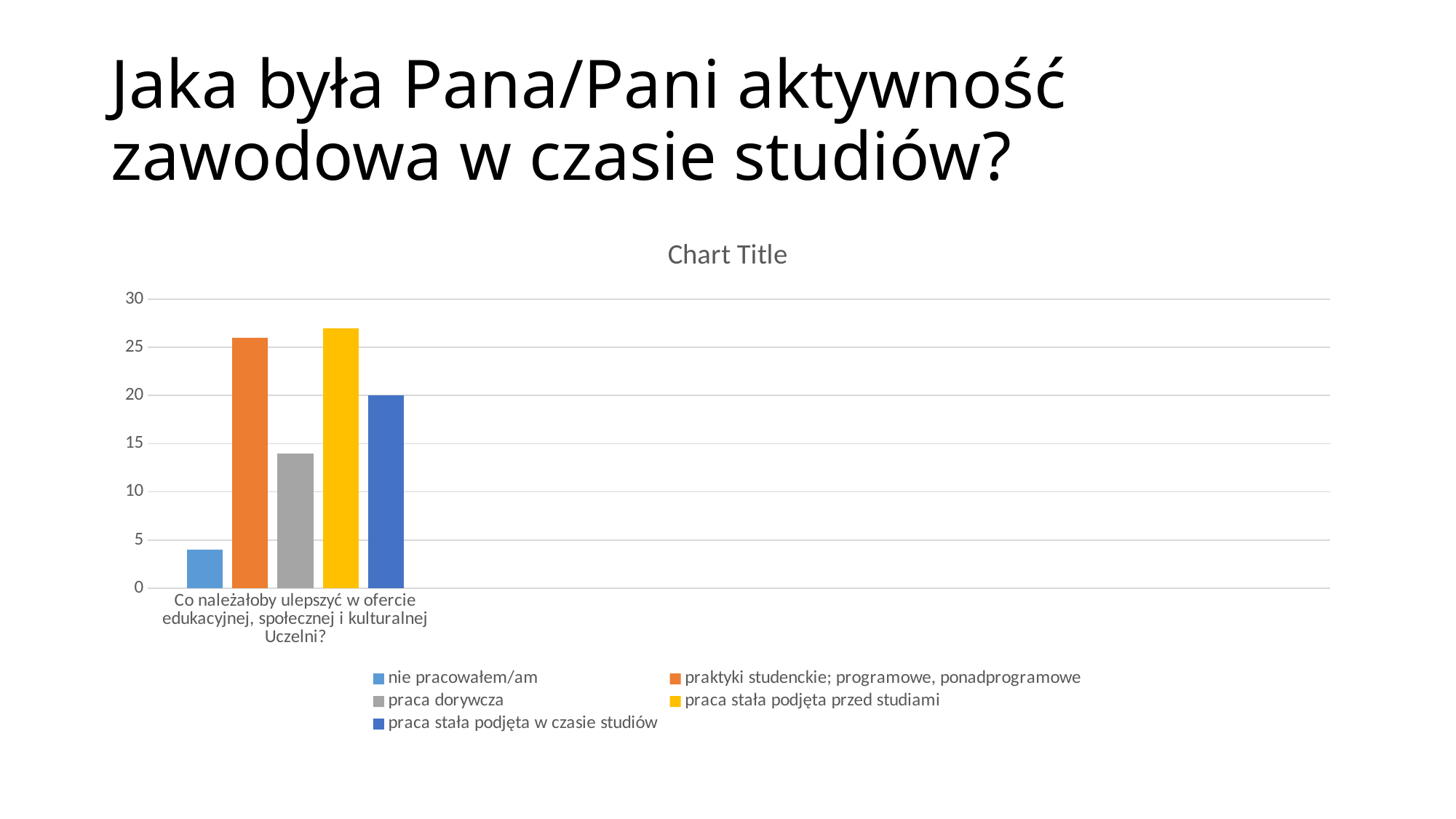
Is the value for "nie pracowałem/am" greater or less than 5? less What kind of chart is shown on the slide? bar chart Is the value for "praca stała podjęta przed studiami" greater or less than 25? greater What colour is the bar for "praca dorywcza"? gray Which is larger: the value for "praca dorywcza" or the value for "praca stała podjęta w czasie studiów"? praca stała podjęta w czasie studiów How many categories are shown on the x axis? 1 What is the title shown above the chart? Chart Title Which series has the lowest value? nie pracowałem/am How many series does the legend list? 5 Is the value for "praca dorywcza" greater or less than 15? less What is the value for "praca stała podjęta w czasie studiów"? 20